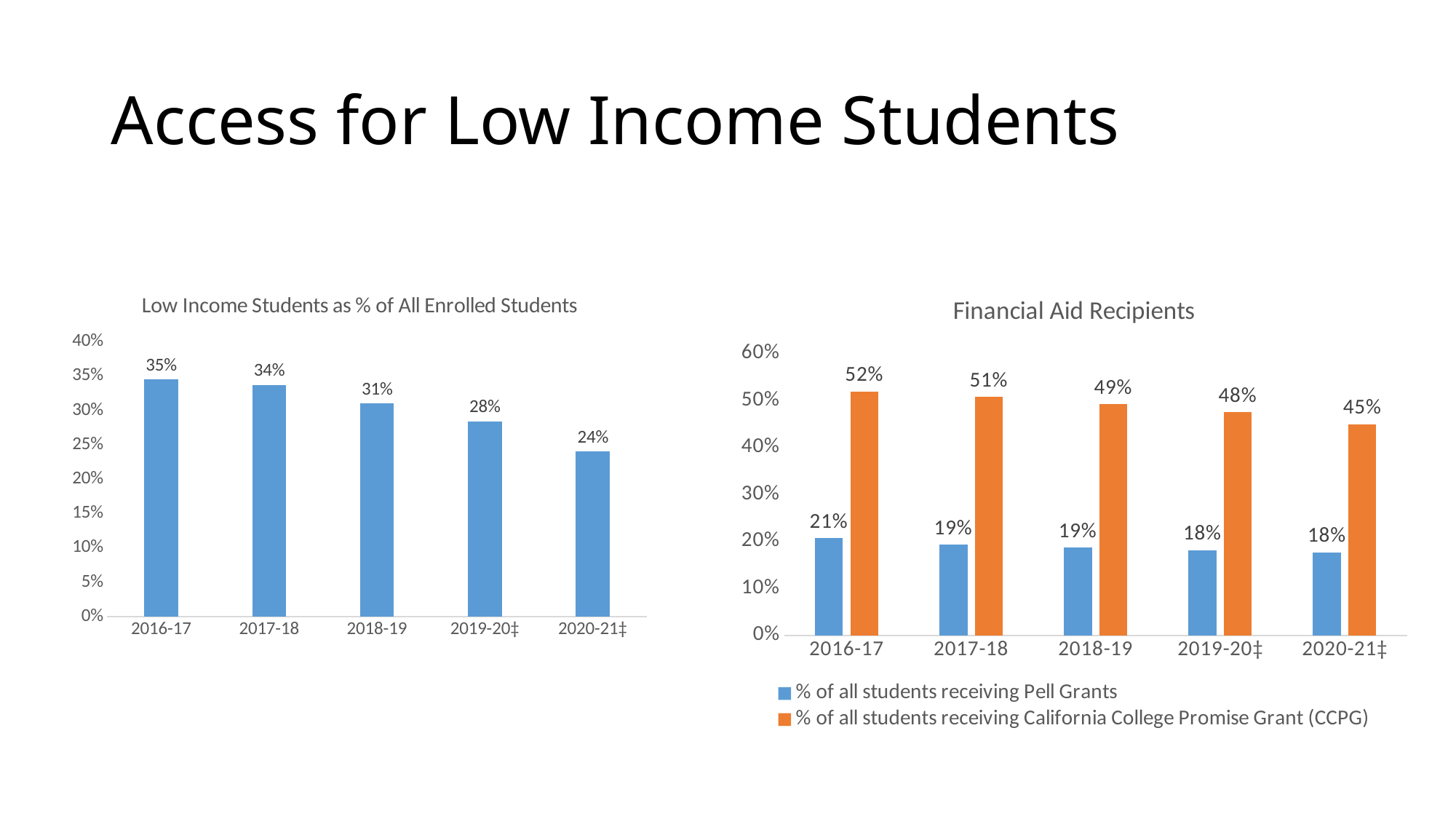
How many years are shown in the 'Low Income Students as % of All Enrolled Students' chart? 5 In the 'Low Income Students as % of All Enrolled Students' chart, what is the value for 2018-19? 31% In the 'Low Income Students as % of All Enrolled Students' chart, what is the difference between the 2016-17 and 2020-21‡ values? 11 percentage points In the 'Low Income Students as % of All Enrolled Students' chart, do the values rise or fall from 2016-17 to 2020-21‡? fall What type of chart is the 'Financial Aid Recipients' chart? bar chart In the 'Financial Aid Recipients' chart, what percentage of all students received the California College Promise Grant (CCPG) in 2019-20‡? 48% In the 'Low Income Students as % of All Enrolled Students' chart, which year has the lowest value? 2020-21‡ How many series does the legend of the 'Financial Aid Recipients' chart list? 2 In the 'Financial Aid Recipients' chart, what percentage of all students received Pell Grants in 2016-17? 21% In the 'Financial Aid Recipients' chart, which is larger in 2017-18: the Pell Grants value or the CCPG value? CCPG In the 'Financial Aid Recipients' chart, which year has the highest CCPG value? 2016-17 In the 'Financial Aid Recipients' chart, what is the difference between the CCPG and Pell Grant values in 2020-21‡? 27 percentage points